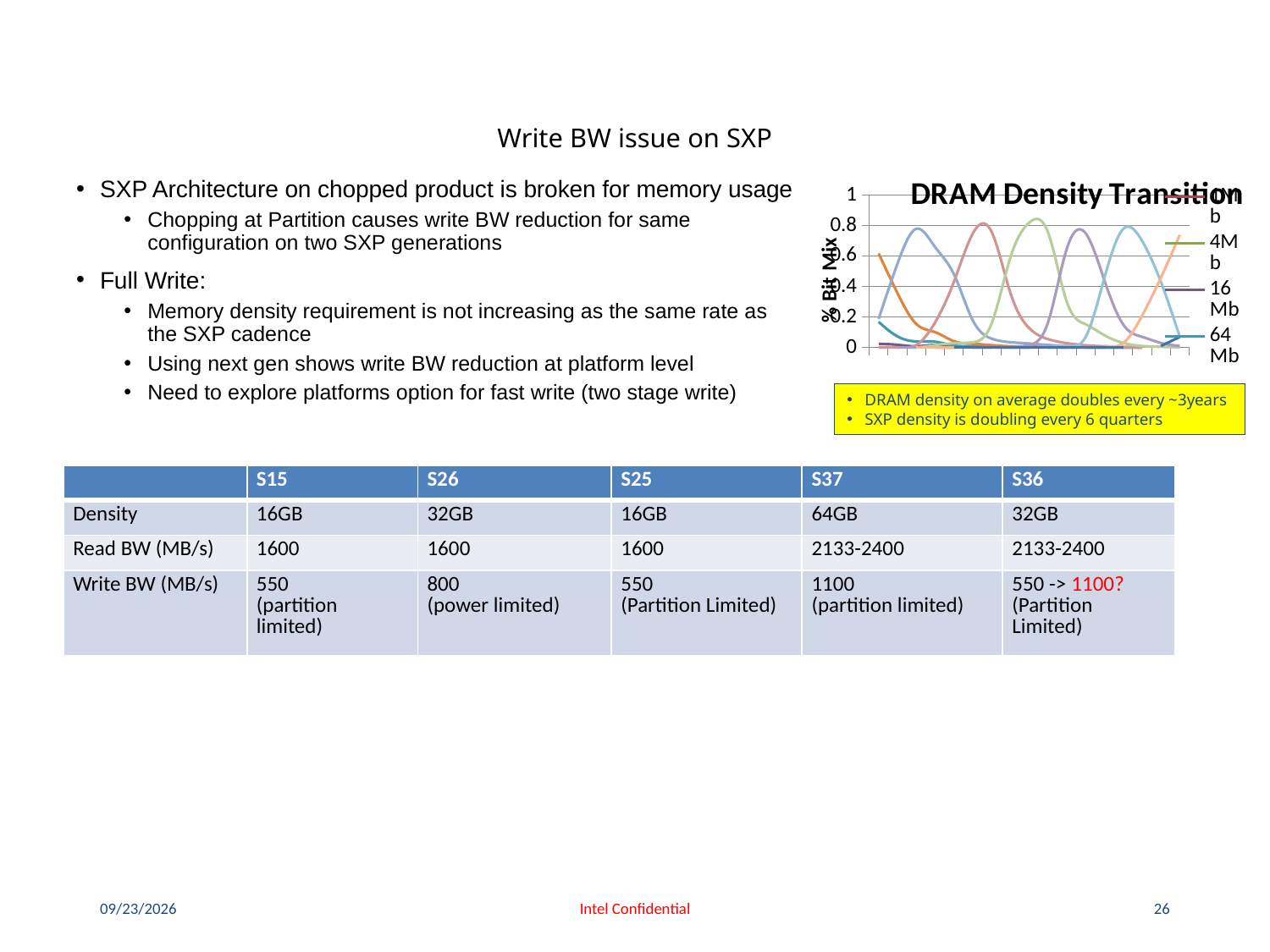
In the DRAM Density Transition chart, is the peak value of the 16Mb series greater or less than 1? less What kind of chart is the DRAM Density Transition chart? line chart What is the label on the y axis of the DRAM Density Transition chart? % Bit Mix What is the title of the chart on the slide? DRAM Density Transition